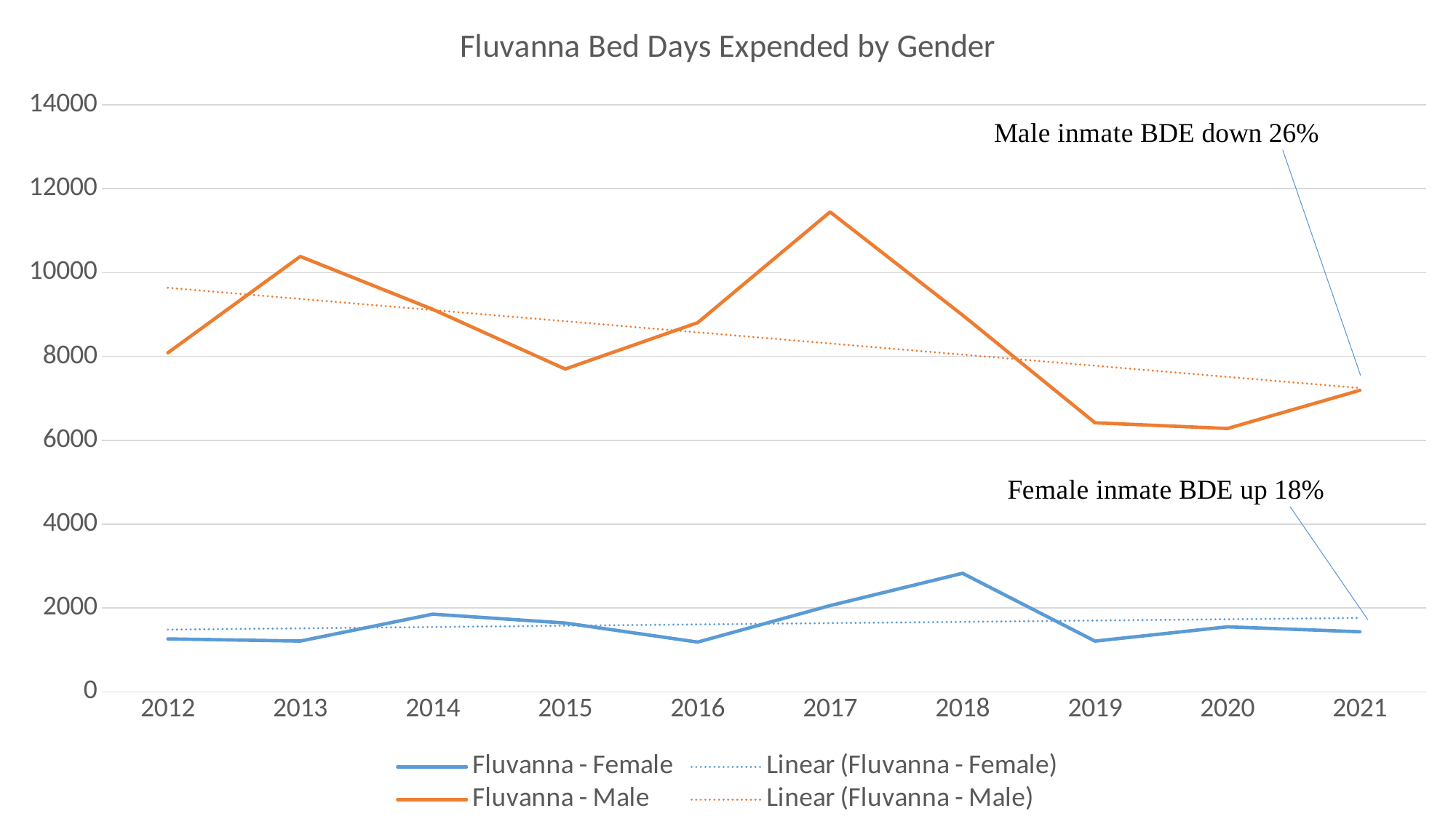
In which year is the Fluvanna - Male series at its highest? 2017 What is the title of the chart? Fluvanna Bed Days Expended by Gender In which year is the Fluvanna - Female series at its highest? 2018 What kind of chart is shown on the slide? Line chart According to the annotation on the chart, by what percentage is female inmate BDE up? 18% How many entries does the chart's legend list? 4 Which is larger, the Fluvanna - Male value in 2013 or in 2015? 2013 How many years are shown along the x axis? 10 Is the value for Fluvanna - Female in 2018 greater or less than 2000? greater Is the value for Fluvanna - Male in 2017 greater or less than 10000? greater Is the value for Fluvanna - Male in 2019 greater or less than 8000? less Does the Linear (Fluvanna - Male) trendline rise or fall from 2012 to 2021? Fall